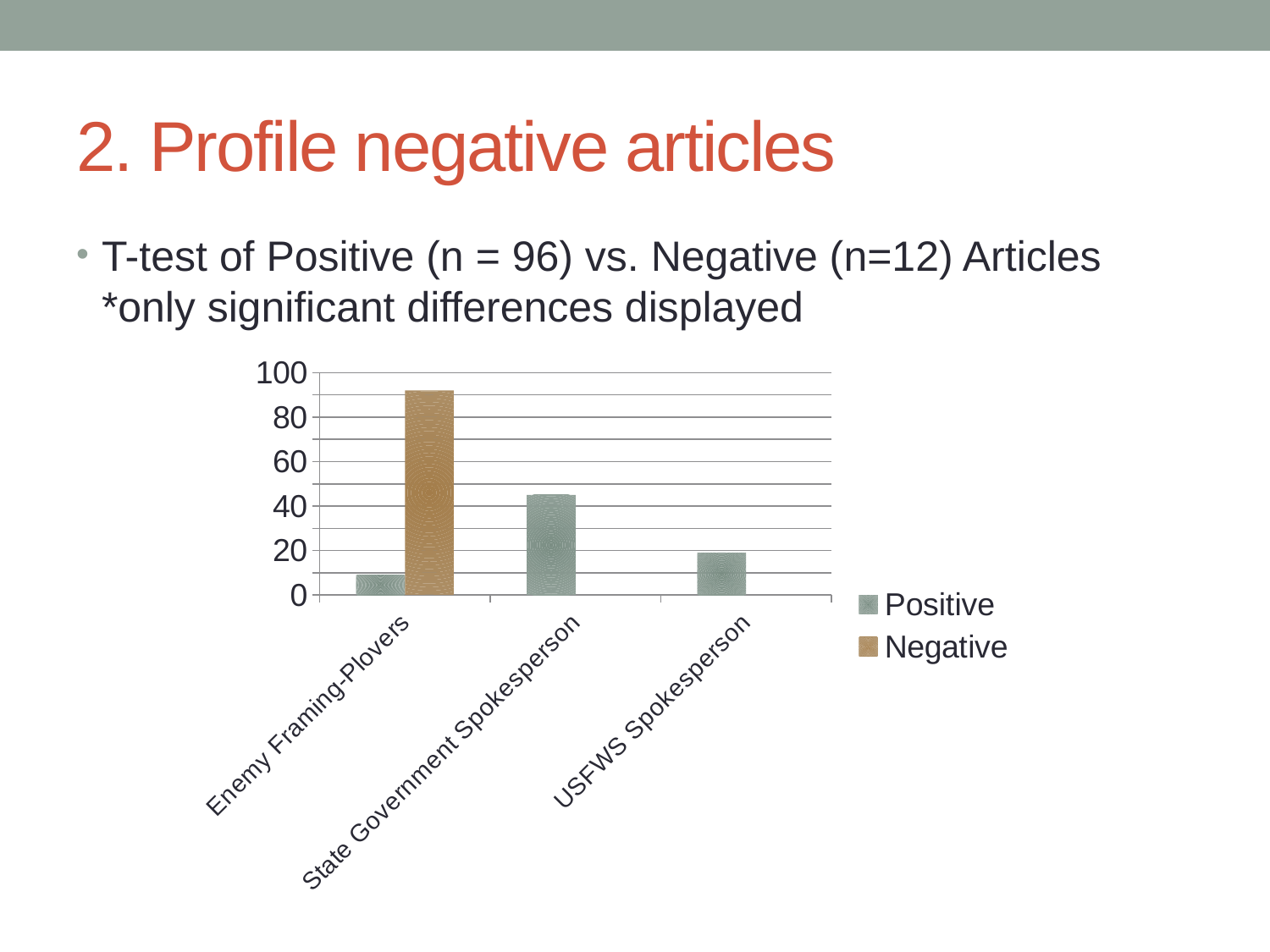
Which series are listed in the chart's legend? Positive and Negative How many series does the chart's legend list? 2 Which category has the highest Positive value? State Government Spokesperson Is the Positive value for USFWS Spokesperson greater or less than 40? less How many categories are shown on the x axis of the chart? 3 What kind of chart is shown on the slide? bar chart Which has the larger Positive value, State Government Spokesperson or USFWS Spokesperson? State Government Spokesperson For Enemy Framing-Plovers, which is larger, the Positive value or the Negative value? Negative Is the Positive value for Enemy Framing-Plovers greater or less than 20? less Which category has the lowest Positive value? Enemy Framing-Plovers Which category has the tallest bar in the chart? Enemy Framing-Plovers Is the Negative value for Enemy Framing-Plovers greater or less than 80? greater